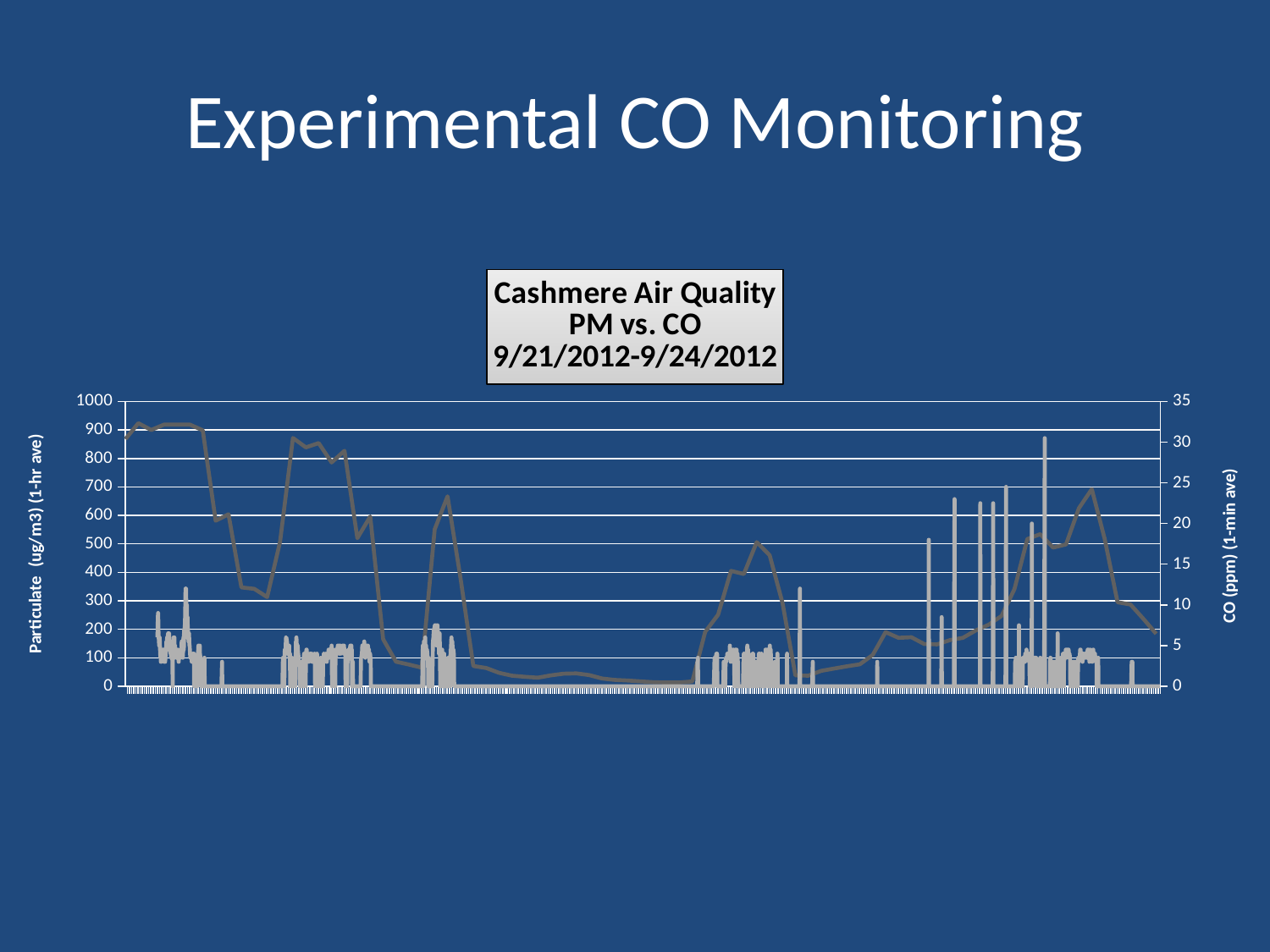
What is the label of the left vertical axis? Particulate (ug/m3) (1-hr ave) What is the title of the chart on the slide? Cashmere Air Quality PM vs. CO 9/21/2012-9/24/2012 What kind of chart is shown on the slide? A combination line and bar chart Is the lowest point of the particulate line greater or less than 100 on the left axis? less What is the maximum value shown on the left vertical axis? 1000 Does the particulate line rise or fall between its starting point at the left edge and the middle of the chart? fall What is the maximum value shown on the right vertical axis? 35 How many vertical axes does the chart have? 2 Is the highest point of the particulate line greater or less than 800 on the left axis? greater What is the label of the right vertical axis? CO (ppm) (1-min ave) What date range does the chart title give? 9/21/2012-9/24/2012